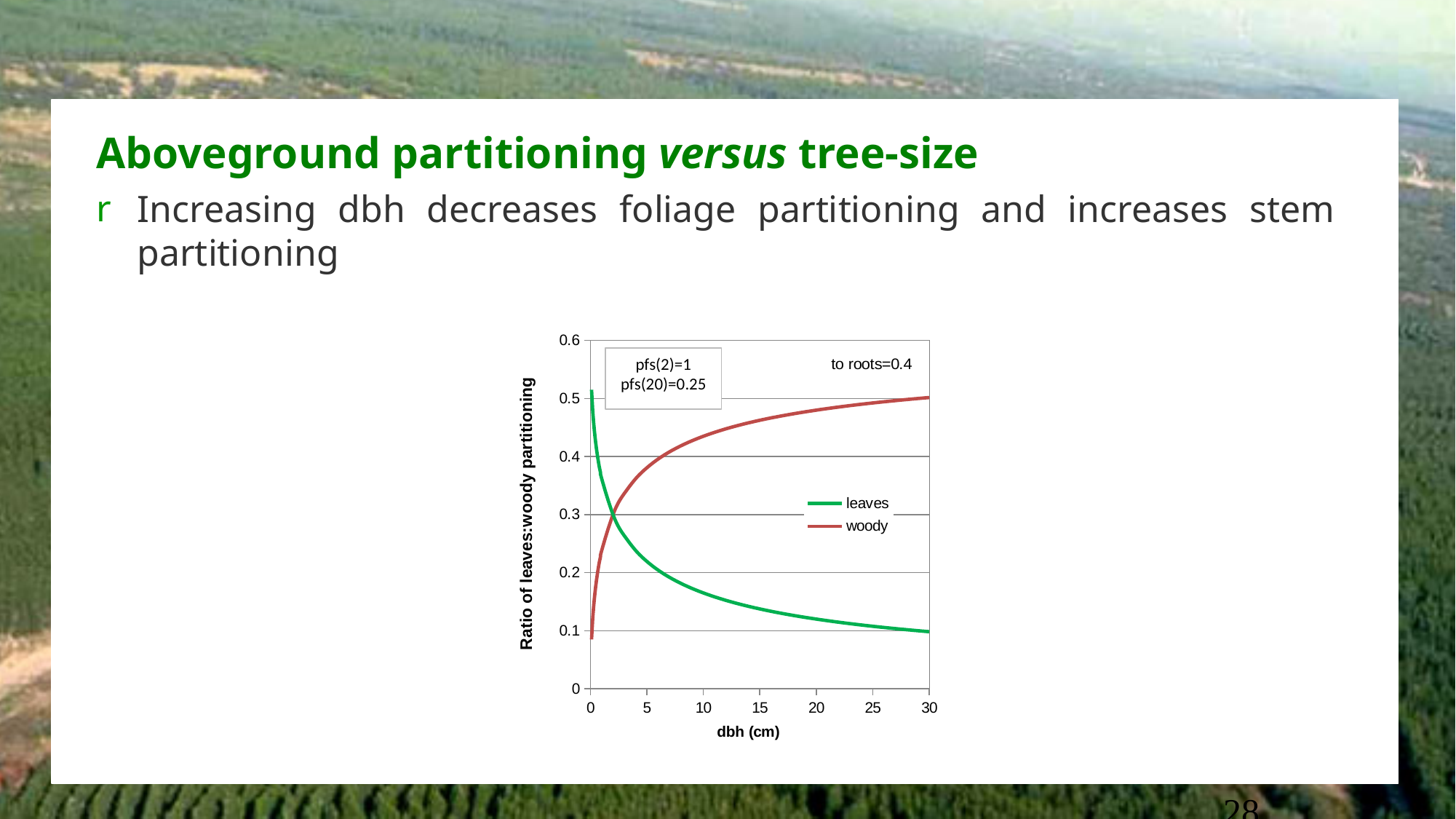
Does the woody series rise or fall as dbh increases? rise Is the value for woody at dbh 20 cm greater or less than 0.4? greater What is the label of the x axis of the chart? dbh (cm) At dbh 20 cm, which series has the larger value, leaves or woody? woody At dbh 0 cm, which series has the larger value, leaves or woody? leaves Is the value for leaves at dbh 20 cm greater or less than 0.2? less Is the value for leaves at dbh 0 cm greater or less than 0.4? greater How many series does the chart legend list? 2 Does the leaves series rise or fall as dbh increases? fall What kind of chart is shown on the slide? line chart Which two series are listed in the chart legend? leaves and woody